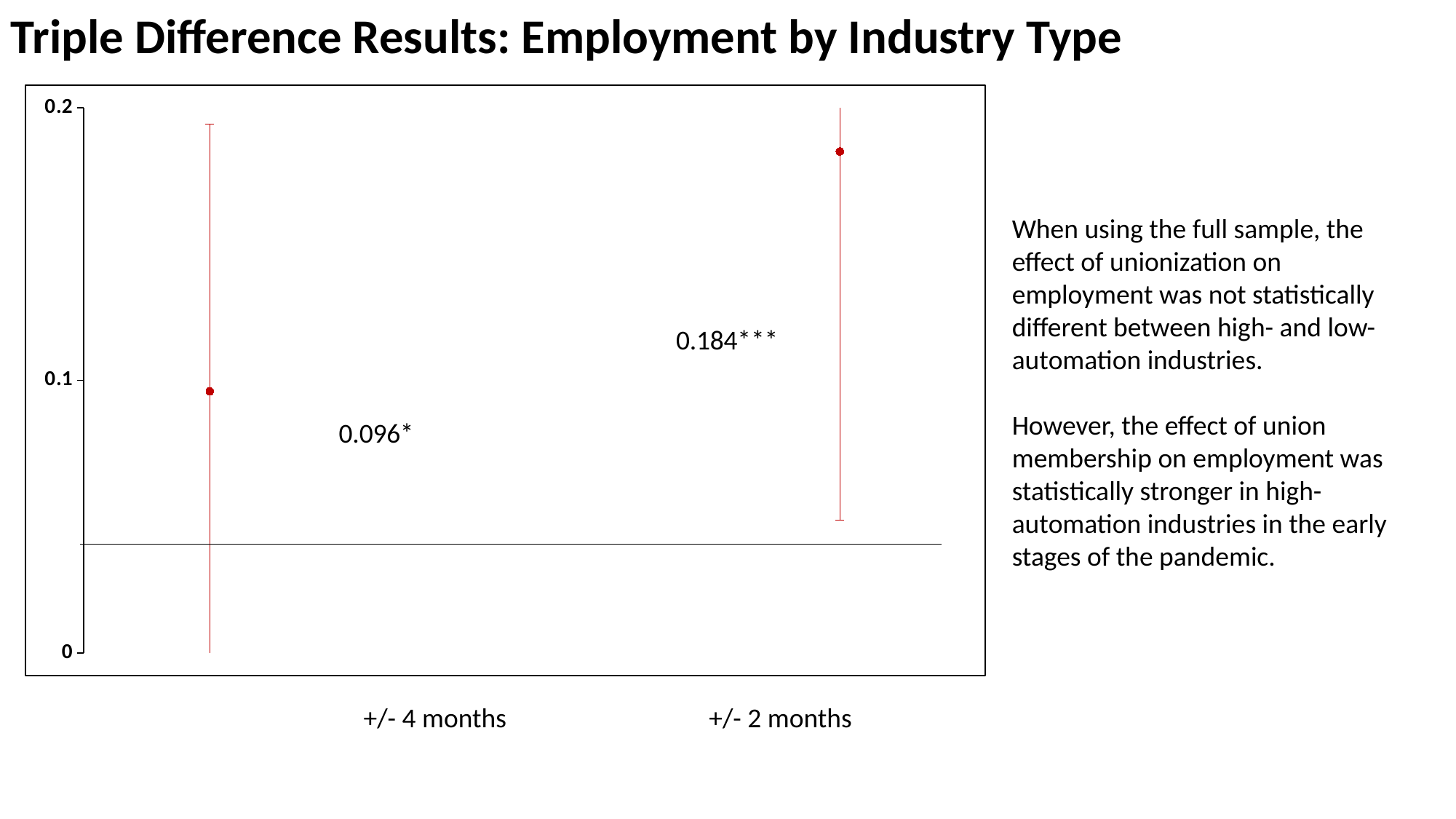
How many asterisks are shown next to the +/- 2 months estimate? 3 What is the estimated value for +/- 2 months? 0.184 What is the estimated value for +/- 4 months? 0.096 Which category has the lowest estimate? +/- 4 months Which estimate is larger, +/- 4 months or +/- 2 months? +/- 2 months What is the title of the chart on the slide? Triple Difference Results: Employment by Industry Type What is the difference between the estimates for +/- 2 months and +/- 4 months? 0.088 How many estimates (categories) are plotted on the chart? 2 What kind of chart is shown on the slide? Dot plot with error bars Which category has the highest estimate? +/- 2 months Do the estimates rise or fall moving from +/- 4 months to +/- 2 months? rise Is the estimate for +/- 2 months greater or less than 0.1? greater